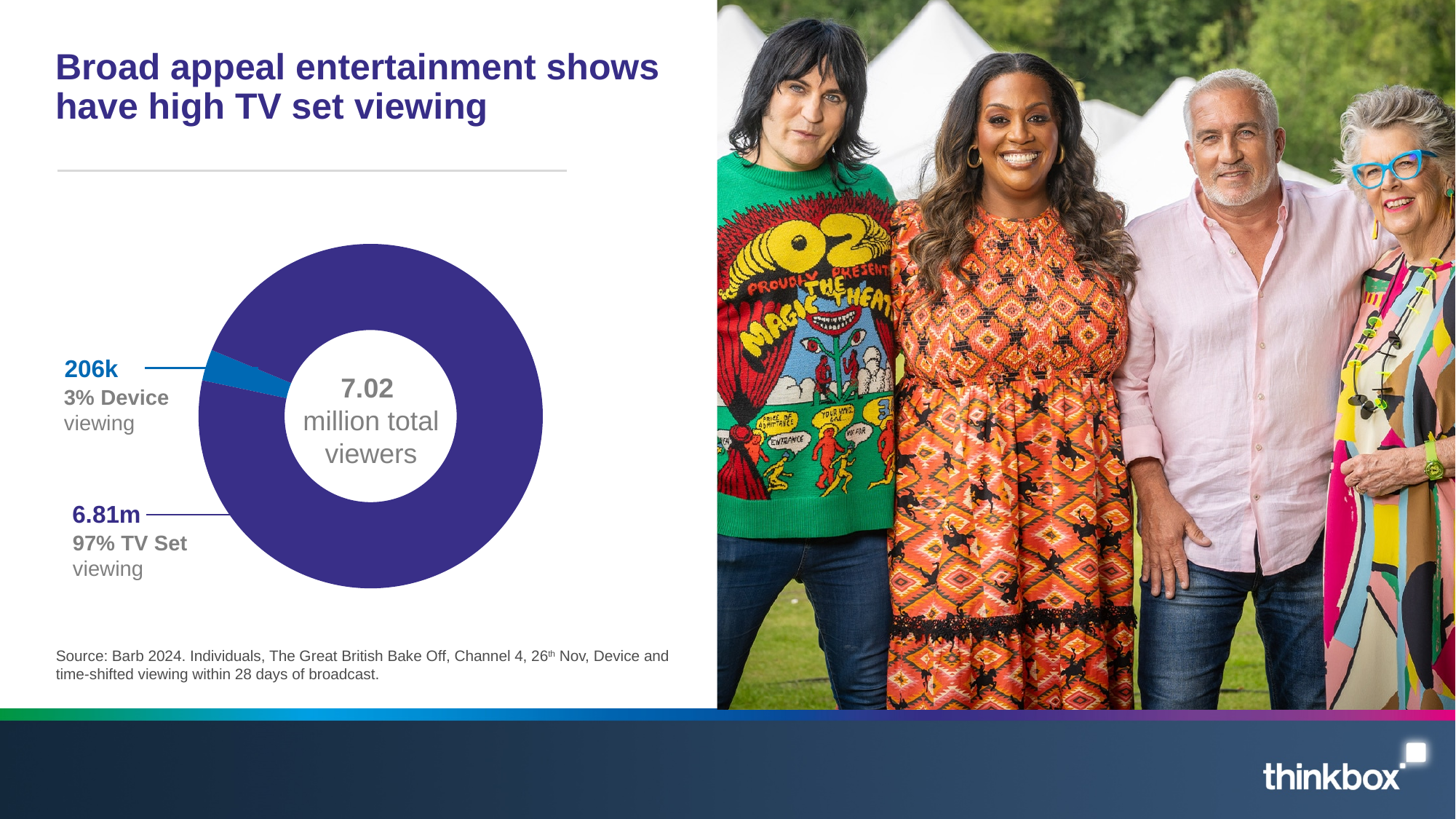
What is the value for Device viewing? 206k What is the title of the slide containing the chart? Broad appeal entertainment shows have high TV set viewing What kind of chart is shown on the slide? Doughnut chart What total number of viewers is shown in the centre of the doughnut chart? 7.02 million How many segments does the doughnut chart have? 2 Which segment is the largest in the doughnut chart? TV Set viewing What share of viewing is Device viewing? 3% What share of viewing is TV Set viewing? 97% What is the value for TV Set viewing? 6.81m Which is larger, TV Set viewing or Device viewing? TV Set viewing Which segment is the smallest in the doughnut chart? Device viewing What colour is the Device viewing segment of the doughnut chart? Blue